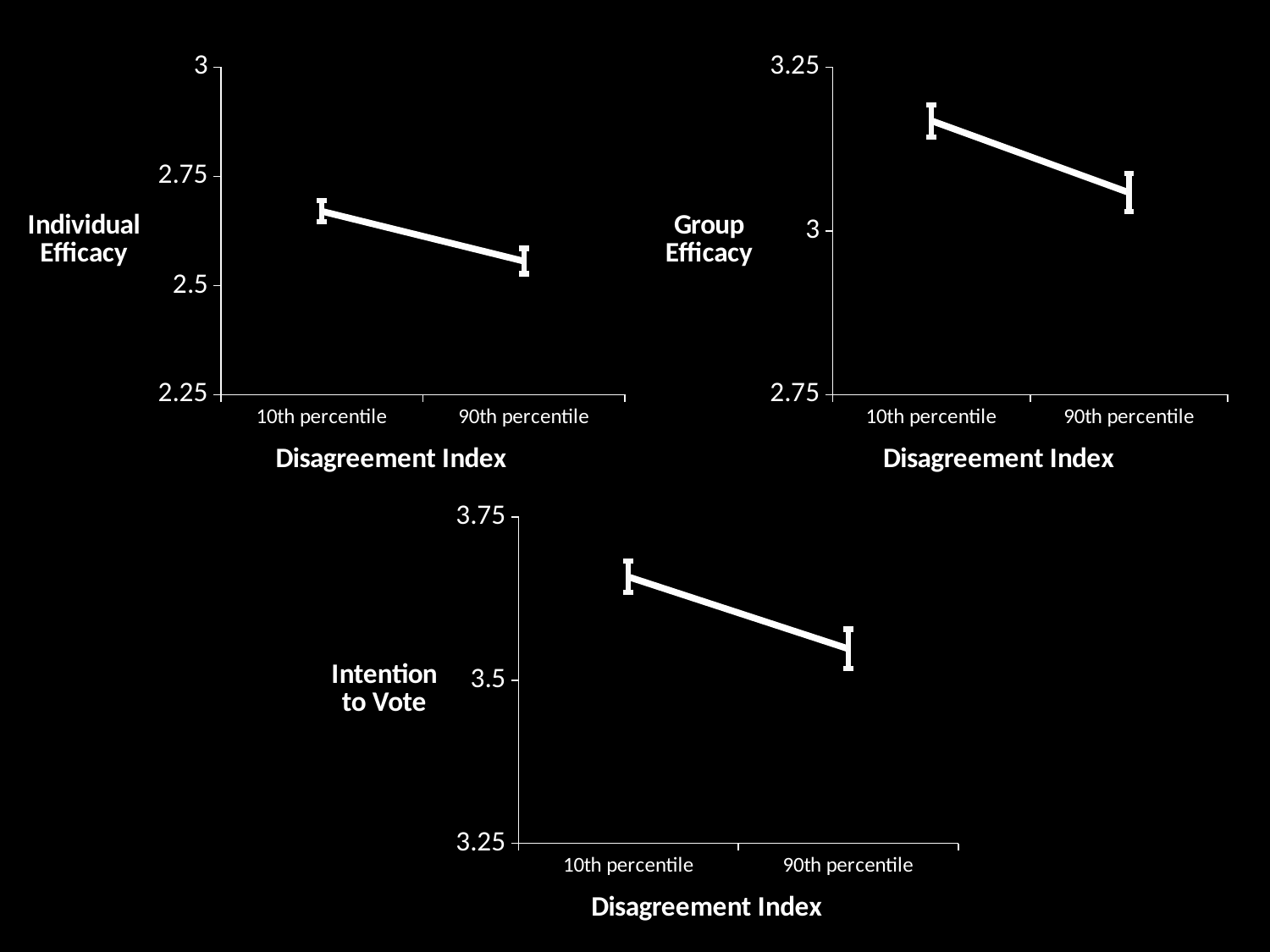
In the Group Efficacy chart, which is larger, the value at the 10th percentile or at the 90th percentile? 10th percentile In the Individual Efficacy chart, is the value for the 90th percentile greater or less than 2.75? less In the Intention to Vote chart, is the value for the 10th percentile greater or less than 3.5? greater How many categories are shown on the x axis of the Individual Efficacy chart? 2 In the Individual Efficacy chart, do the values rise or fall from the 10th percentile to the 90th percentile? fall In the Intention to Vote chart, which category has the highest value? 10th percentile In the Group Efficacy chart, is the value for the 90th percentile greater or less than 3.25? less What kind of chart is the Group Efficacy chart? line chart What is the x-axis title of the Intention to Vote chart? Disagreement Index